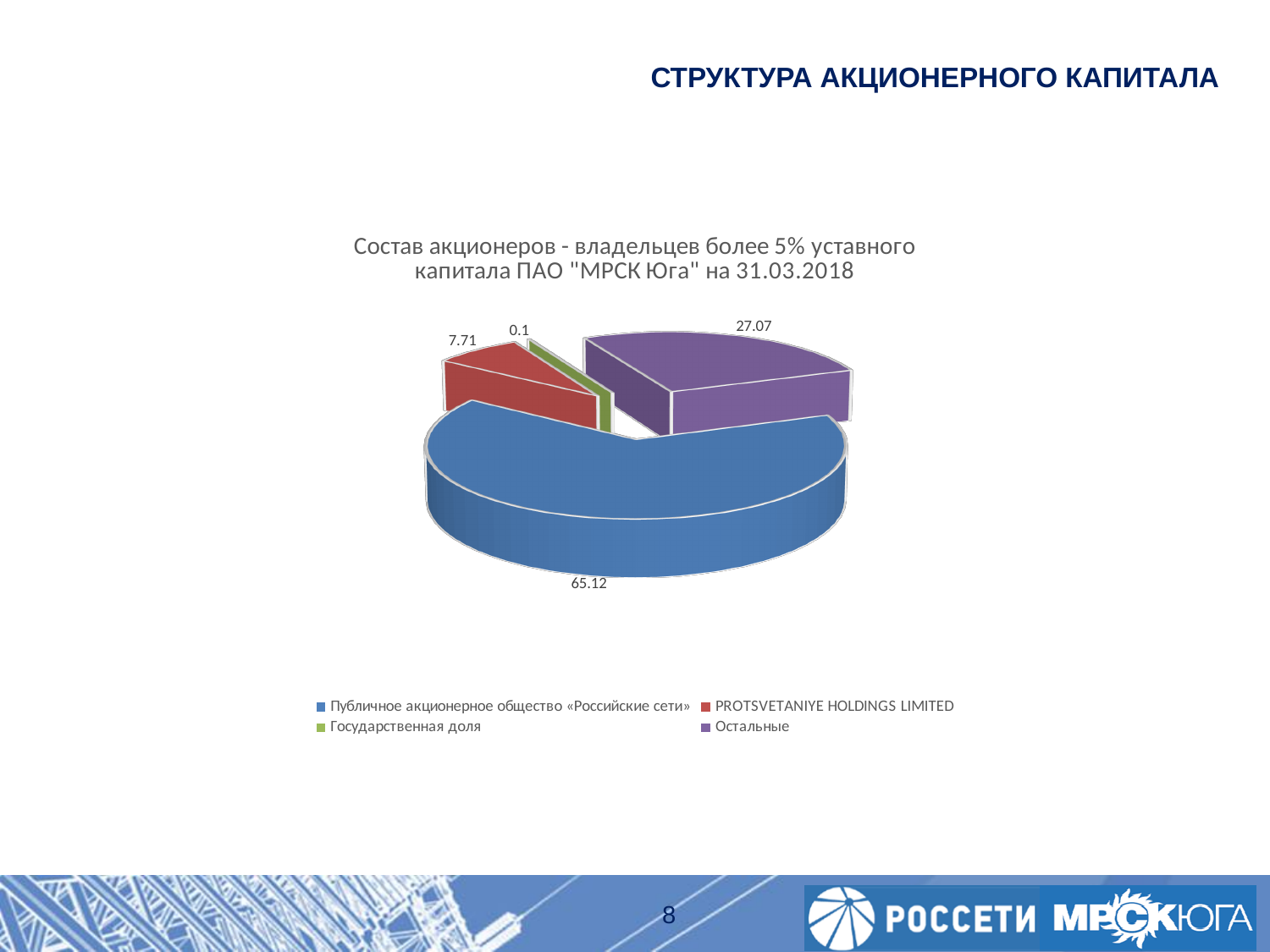
What is the difference between the values for Публичное акционерное общество «Российские сети» and Остальные? 38.05 What is the value for Остальные? 27.07 What is the title of the chart? Состав акционеров - владельцев более 5% уставного капитала ПАО "МРСК Юга" на 31.03.2018 How many categories does the pie chart show? 4 Which category has the largest slice of the pie? Публичное акционерное общество «Российские сети» What is the value for Публичное акционерное общество «Российские сети»? 65.12 What type of chart is shown on the slide? Pie chart Which category has the smallest slice of the pie? Государственная доля What is the value for Государственная доля? 0.1 What is the value for PROTSVETANIYE HOLDINGS LIMITED? 7.71 Which is larger, the value for Остальные or the value for PROTSVETANIYE HOLDINGS LIMITED? Остальные What is the difference between the values for Остальные and PROTSVETANIYE HOLDINGS LIMITED? 19.36